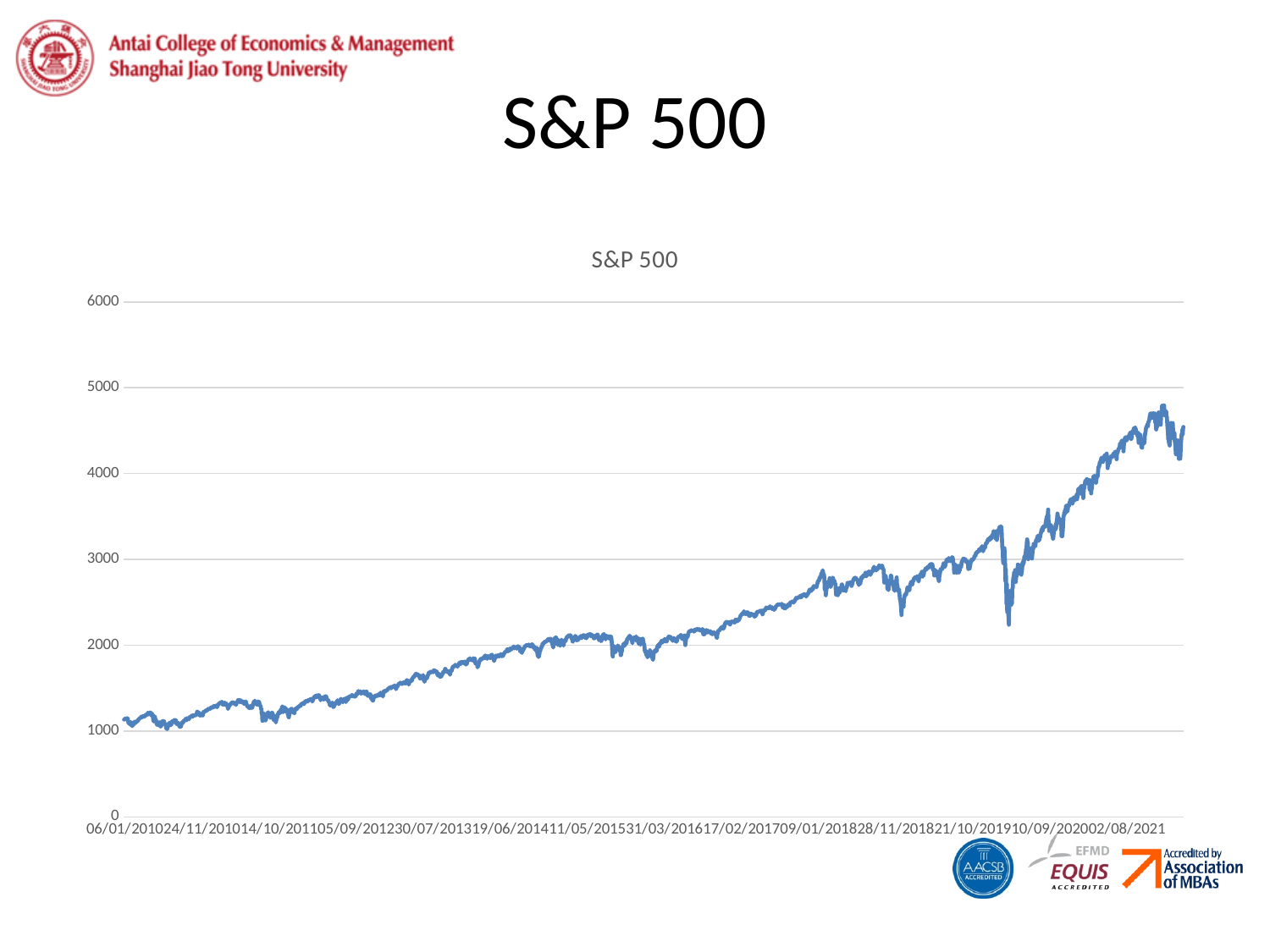
Overall, do the S&P 500 values rise or fall from left to right along the x axis? rise Is the S&P 500 value at the end of the series (02/08/2021) greater or less than 4000? greater How many date labels are shown along the x axis? 14 Is the S&P 500 value around 09/01/2018 greater or less than 2000? greater Is the highest S&P 500 value on the chart greater or less than 5000? less What is the highest value shown on the y axis? 6000 What kind of chart is shown on the slide? line chart What is the title of the chart? S&P 500